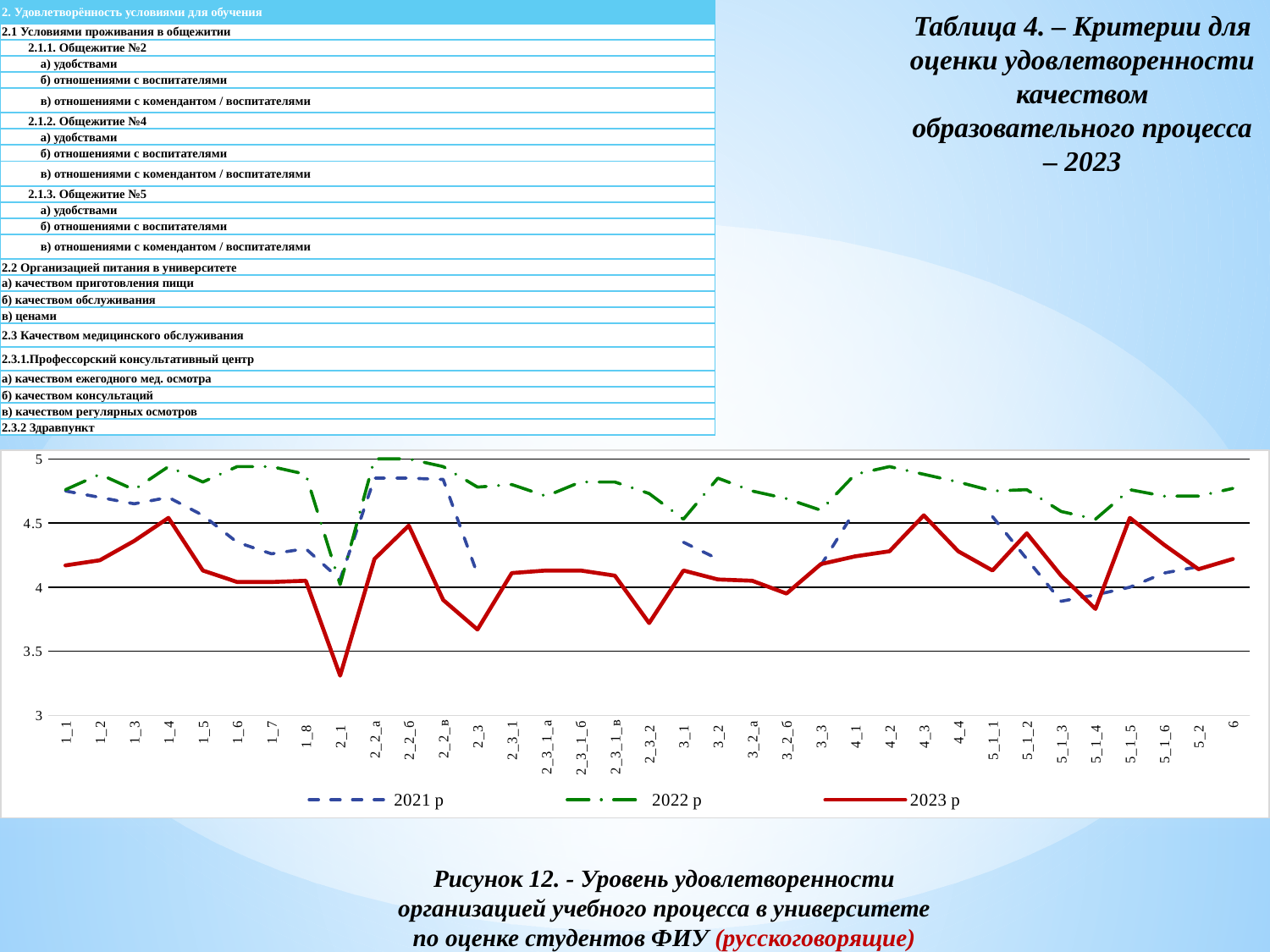
At category 1_1, which series has the larger value: 2022 р or 2023 р? 2022 р At which category does the 2023 р series reach its lowest value? 2_1 Is the value of the 2023 р series at 2_1 greater or less than 3.5? less Is the value of the 2023 р series at 1_1 greater or less than 4.5? less Is the value of the 2021 р series at 5_1_3 greater or less than 4? less How many categories are shown along the x axis of the chart? 35 How many series does the chart legend list? 3 At category 2_1, which series has the larger value: 2021 р or 2023 р? 2021 р What kind of chart is shown on the slide? line chart Which series are listed in the chart legend? 2021 р, 2022 р, 2023 р